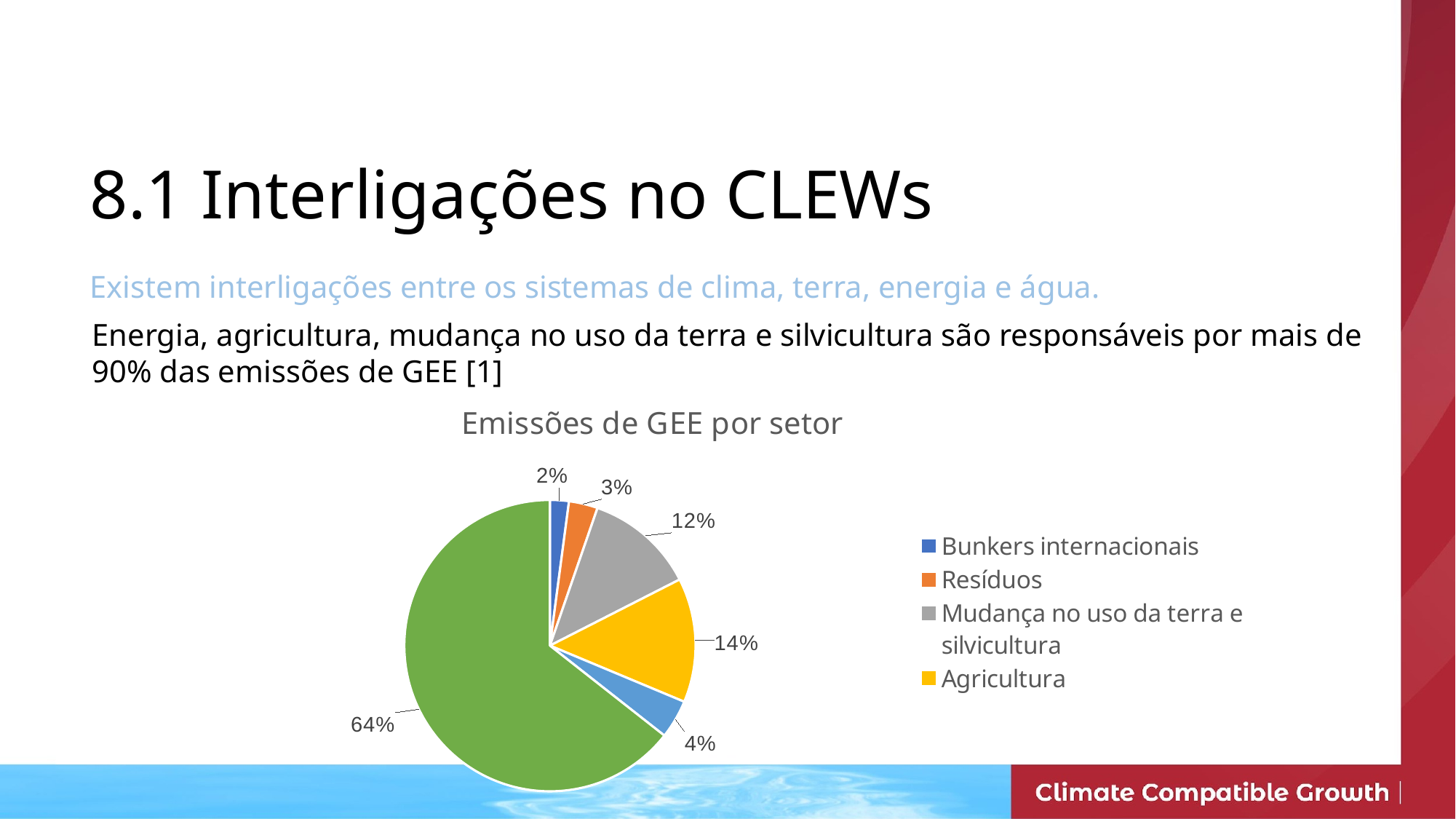
What share of the pie does Mudança no uso da terra e silvicultura have? 12% How many slices does the pie chart have? 6 What share of the pie does Resíduos have? 3% What is the percentage shown for the largest slice of the pie? 64% Which is larger, the share for Agricultura or the share for Mudança no uso da terra e silvicultura? Agricultura What share of the pie does Bunkers internacionais have? 2% What is the difference between the shares for Agricultura and Resíduos? 11% How many entries does the legend list? 4 Which legend entry has the smallest share of the pie? Bunkers internacionais What kind of chart is shown on the slide? pie chart What is the title of the chart? Emissões de GEE por setor